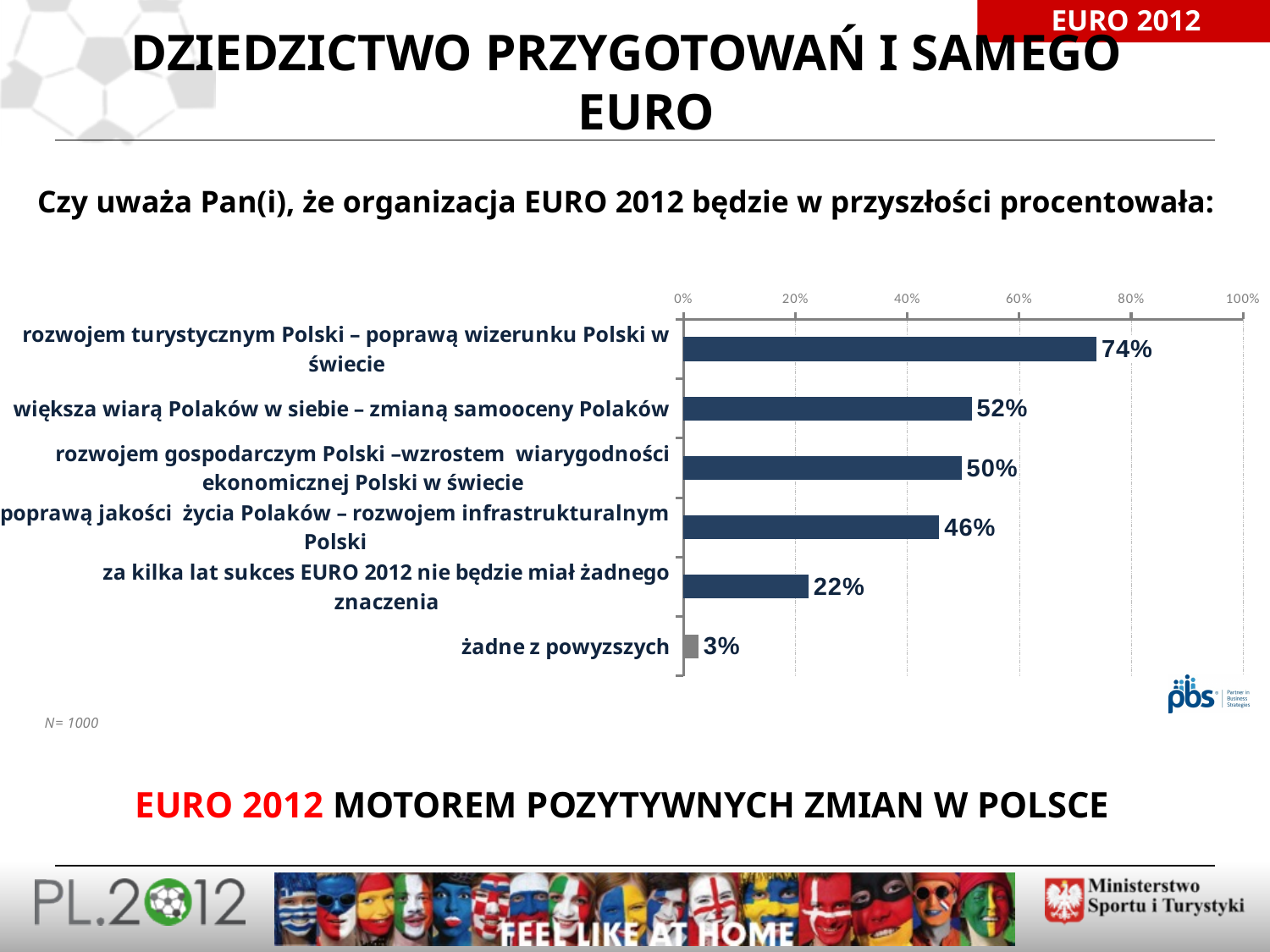
What is the value for 'większa wiarą Polaków w siebie – zmianą samooceny Polaków'? 52% What kind of chart is shown on the slide? bar chart What is the sample size (N) stated below the chart? N= 1000 What percentage of respondents said EURO 2012 will pay off through the tourism development of Poland (rozwojem turystycznym Polski)? 74% What is the value for 'żadne z powyzszych'? 3% What is the value for 'za kilka lat sukces EURO 2012 nie będzie miał żadnego znaczenia'? 22% Which category has the highest value? rozwojem turystycznym Polski – poprawą wizerunku Polski w świecie How many categories are shown in the chart? 6 What is the difference between the value for 'rozwojem turystycznym Polski' and the value for 'większa wiarą Polaków w siebie'? 22% Which is larger: the value for 'rozwojem gospodarczym Polski' or the value for 'poprawą jakości życia Polaków'? rozwojem gospodarczym Polski Is the value for 'poprawą jakości życia Polaków – rozwojem infrastrukturalnym Polski' greater or less than 40%? greater Which category has the lowest value? żadne z powyzszych